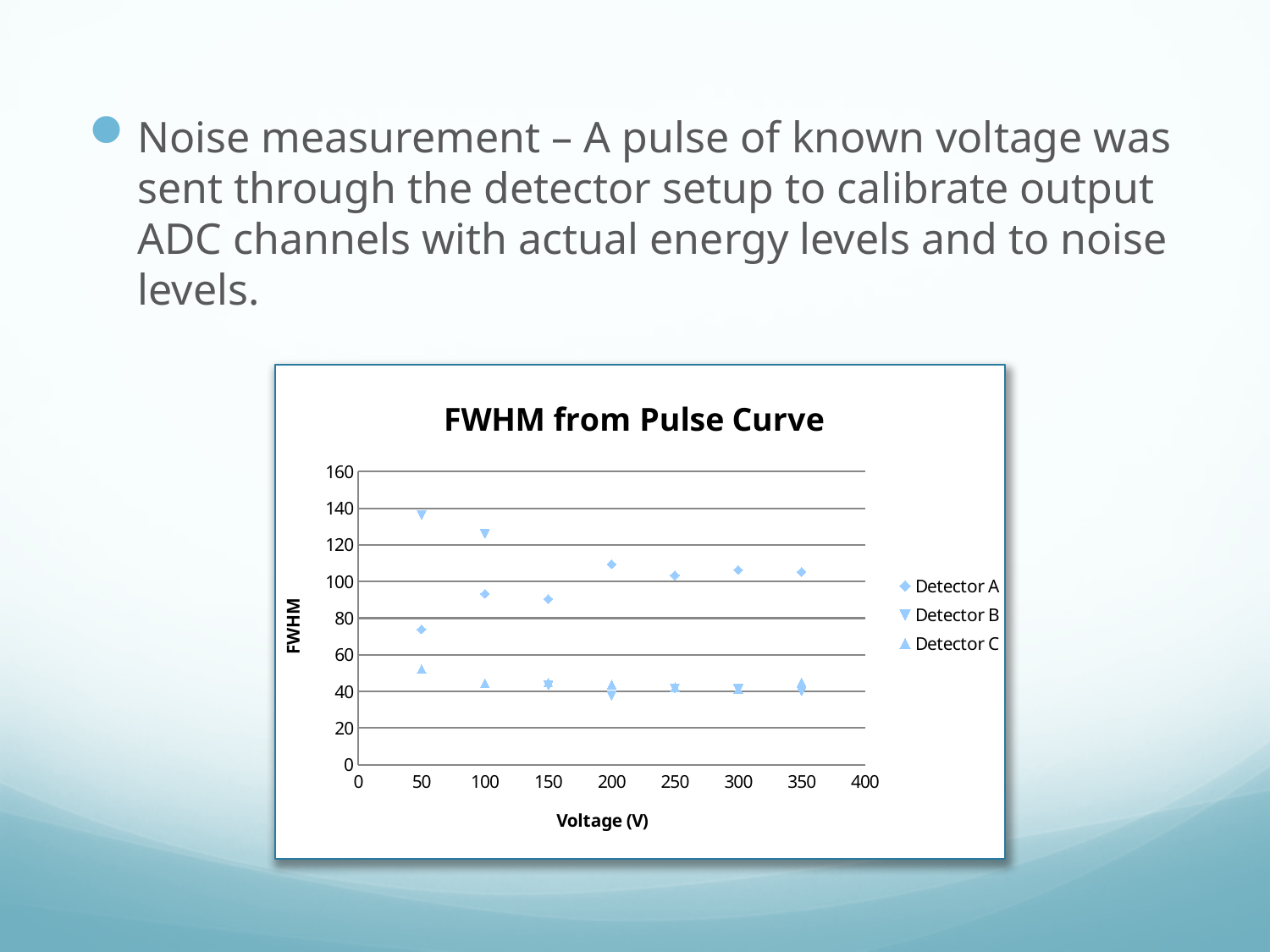
Which series has the higher value at 100 V, Detector A or Detector B? Detector B What is the label of the x axis? Voltage (V) How many series does the legend list? 3 Is the value for Detector A at 200 V greater or less than 100? greater Is the value for Detector A at 50 V greater or less than 80? less Is the value for Detector C at 50 V greater or less than 60? less What is the title of the chart? FWHM from Pulse Curve What kind of chart is shown on the slide? Scatter chart Which series has the higher value at 300 V, Detector A or Detector C? Detector A At which voltage does Detector B reach its highest FWHM value? 50